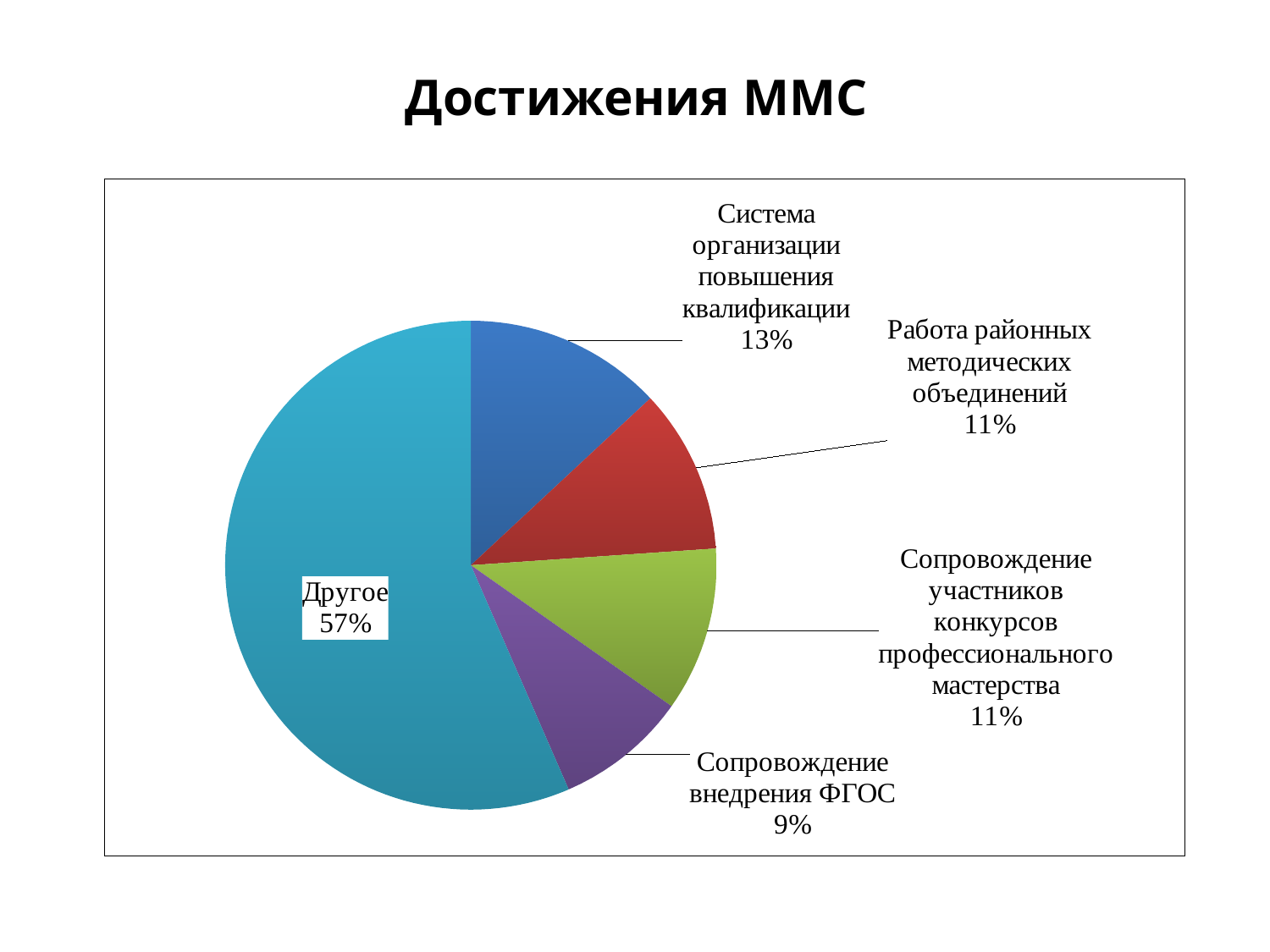
What is the difference between the shares of "Система организации повышения квалификации" and "Сопровождение внедрения ФГОС"? 4% Which category has the smallest slice of the pie? Сопровождение внедрения ФГОС How many slices does the pie chart have? 5 What is the title of the slide? Достижения ММС What is the value for "Система организации повышения квалификации"? 13% What is the value for "Сопровождение внедрения ФГОС"? 9% What share of the pie does "Другое" take? 57% Which is larger: the share for "Система организации повышения квалификации" or for "Сопровождение внедрения ФГОС"? Система организации повышения квалификации Which category has the largest slice of the pie? Другое What is the value for "Работа районных методических объединений"? 11% What is the difference between the shares of "Другое" and "Система организации повышения квалификации"? 44% What kind of chart is shown on the slide? pie chart